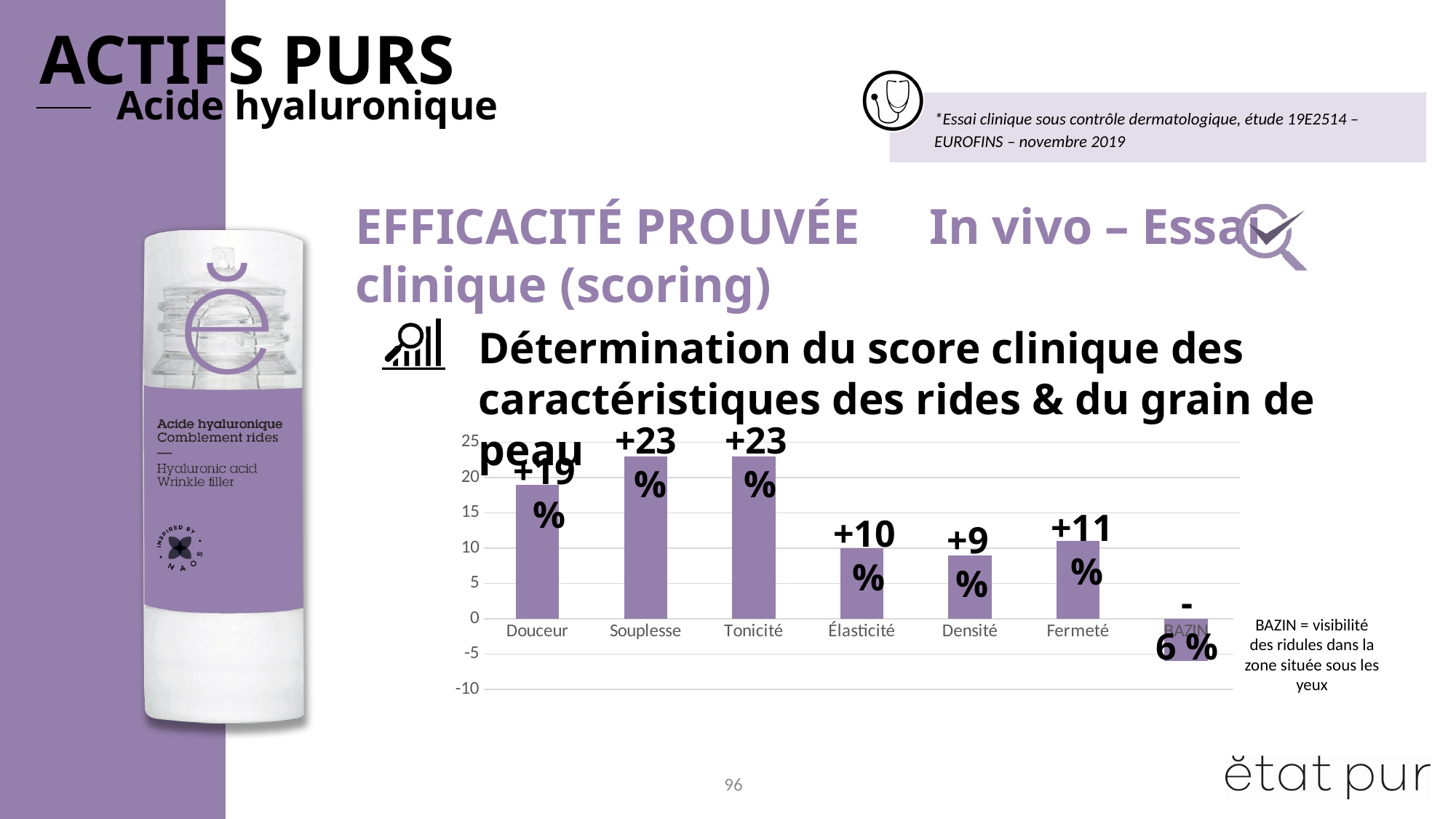
What is the value shown for Densité? +9 % According to the note next to the chart, what does BAZIN refer to? Visibilité des ridules dans la zone située sous les yeux What is the value shown for Élasticité? +10 % Which category has the lowest value in the chart? BAZIN What is the value shown for BAZIN? -6 % What is the difference between the values for Douceur and Élasticité? 9 percentage points What is the value shown for Douceur? +19 % Which two categories share the highest value of +23 %? Souplesse and Tonicité What is the value shown for Fermeté? +11 % How many categories are shown on the x axis of the chart? 7 Which is larger, the value for Douceur or the value for Fermeté? Douceur What kind of chart is shown on the slide? Bar chart